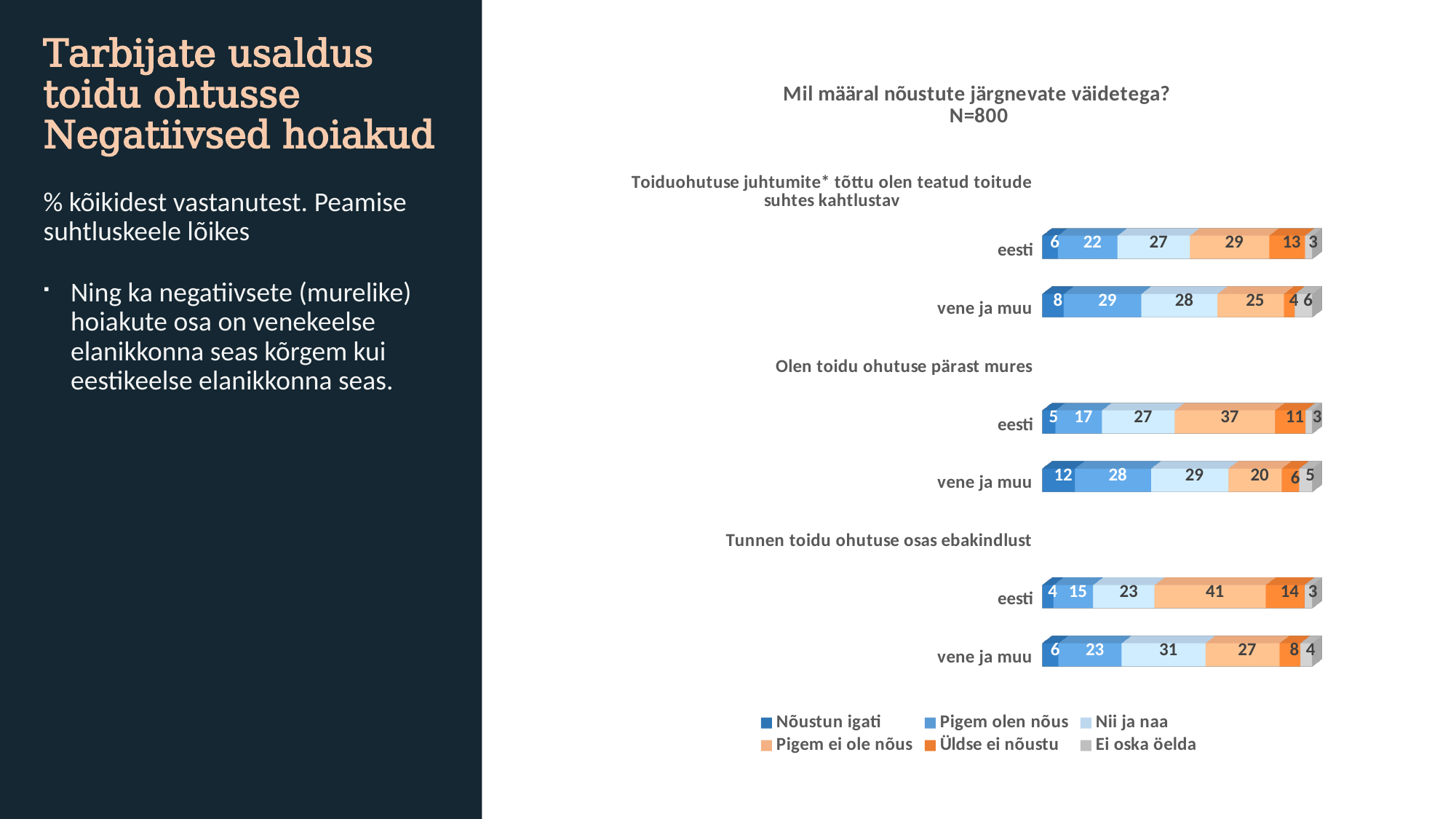
What type of chart is shown on the slide? stacked bar chart For the statement 'Toiduohutuse juhtumite* tõttu olen teatud toitude suhtes kahtlustav', what is the difference between the 'Üldse ei nõustu' values of the eesti and vene ja muu groups? 9 What is the total of the eesti bar for 'Olen toidu ohutuse pärast mures'? 100 What sample size (N) is stated in the chart title? N=800 For the statement 'Olen toidu ohutuse pärast mures', what is the 'Pigem ei ole nõus' value for the eesti group? 37 How many bars are plotted in the chart? 6 For the statement 'Toiduohutuse juhtumite* tõttu olen teatud toitude suhtes kahtlustav', what is the 'Nõustun igati' value for the vene ja muu group? 8 For the statement 'Tunnen toidu ohutuse osas ebakindlust', what is the 'Nii ja naa' value for the vene ja muu group? 31 How many series does the chart legend list? 6 For the statement 'Olen toidu ohutuse pärast mures', what is the difference between the 'Nõustun igati' values of the vene ja muu group and the eesti group? 7 For the statement 'Tunnen toidu ohutuse osas ebakindlust', which group has the larger 'Pigem olen nõus' value, eesti or vene ja muu? vene ja muu Which segment is the largest in the eesti bar for 'Tunnen toidu ohutuse osas ebakindlust'? Pigem ei ole nõus